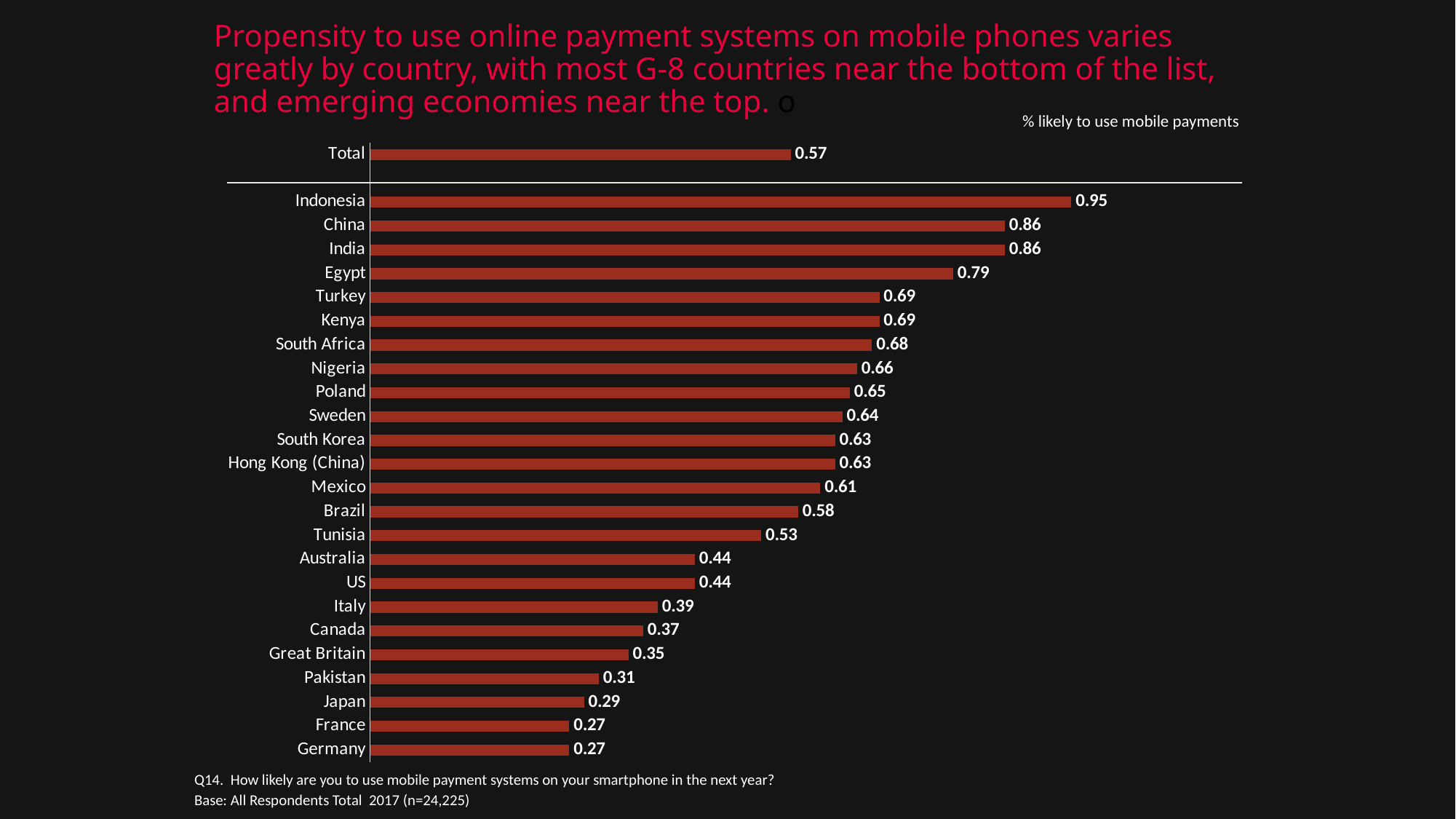
What is the value for Total? 0.57 Which country has the highest value? Indonesia Do the country values rise or fall going down the chart from Indonesia to Germany? Fall What is the difference between the values for Egypt and Brazil? 0.21 Which is larger, the value for Canada or the value for Italy? Italy What is the value for Indonesia? 0.95 What kind of chart is shown on the slide? Bar chart What is the value for Japan? 0.29 What is the value for Great Britain? 0.35 Which is larger, the value for Mexico or the value for Tunisia? Mexico What is the difference between the values for Indonesia and Germany? 0.68 How many countries are listed below the Total bar? 24